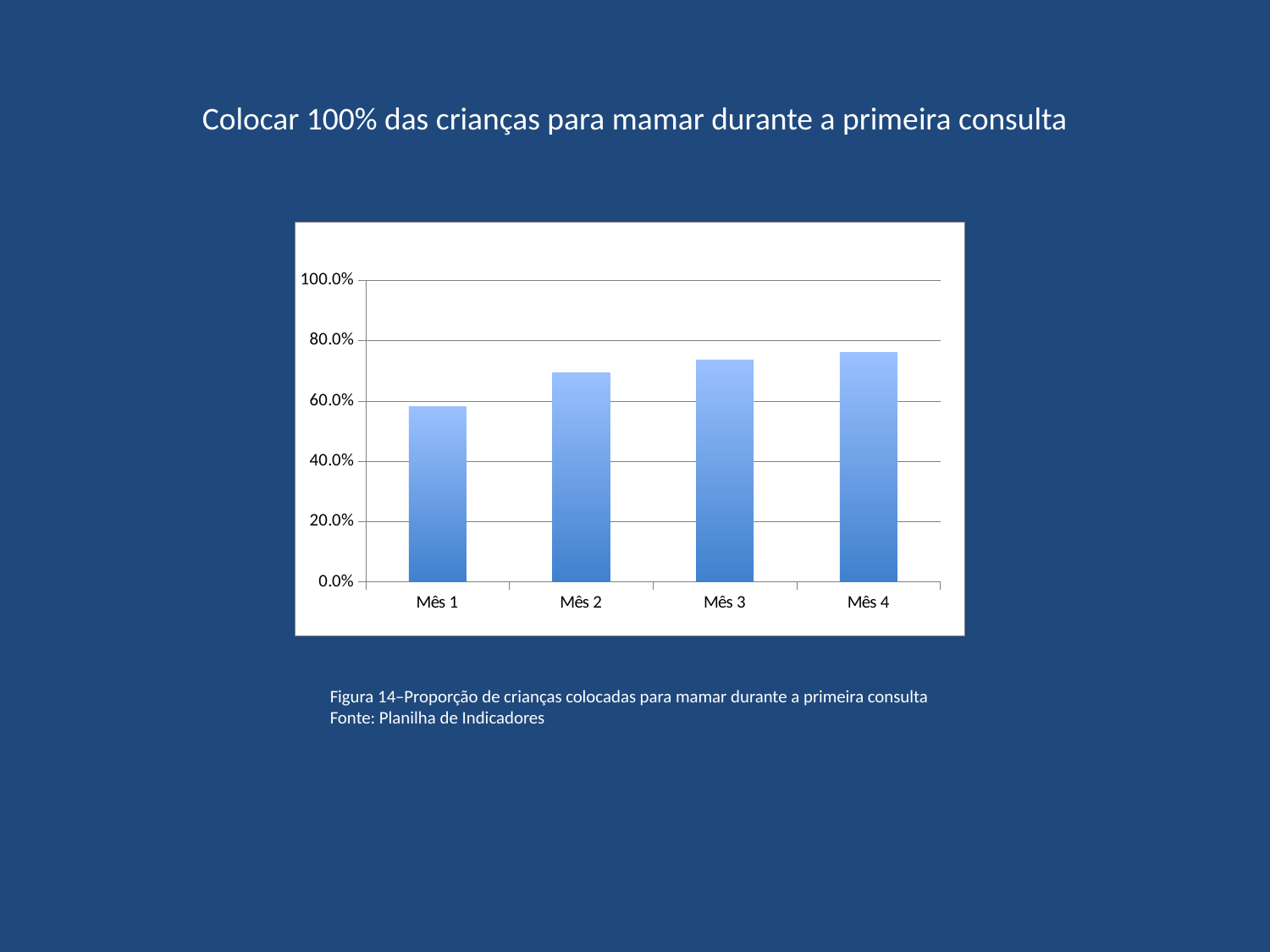
Is the value for Mês 2 greater or less than 60.0%? greater What kind of chart is shown on the slide? bar chart What is the figure number given in the caption below the chart? Figura 14 Which month has the lowest bar? Mês 1 Which is larger, the value for Mês 1 or the value for Mês 2? Mês 2 Is the value for Mês 1 greater or less than 80.0%? less Is the value for Mês 4 greater or less than 60.0%? greater How many categories (months) are plotted on the x axis? 4 Do the values rise or fall from Mês 1 to Mês 4? rise Which month has the highest bar? Mês 4 What is the highest value shown on the vertical axis? 100.0%